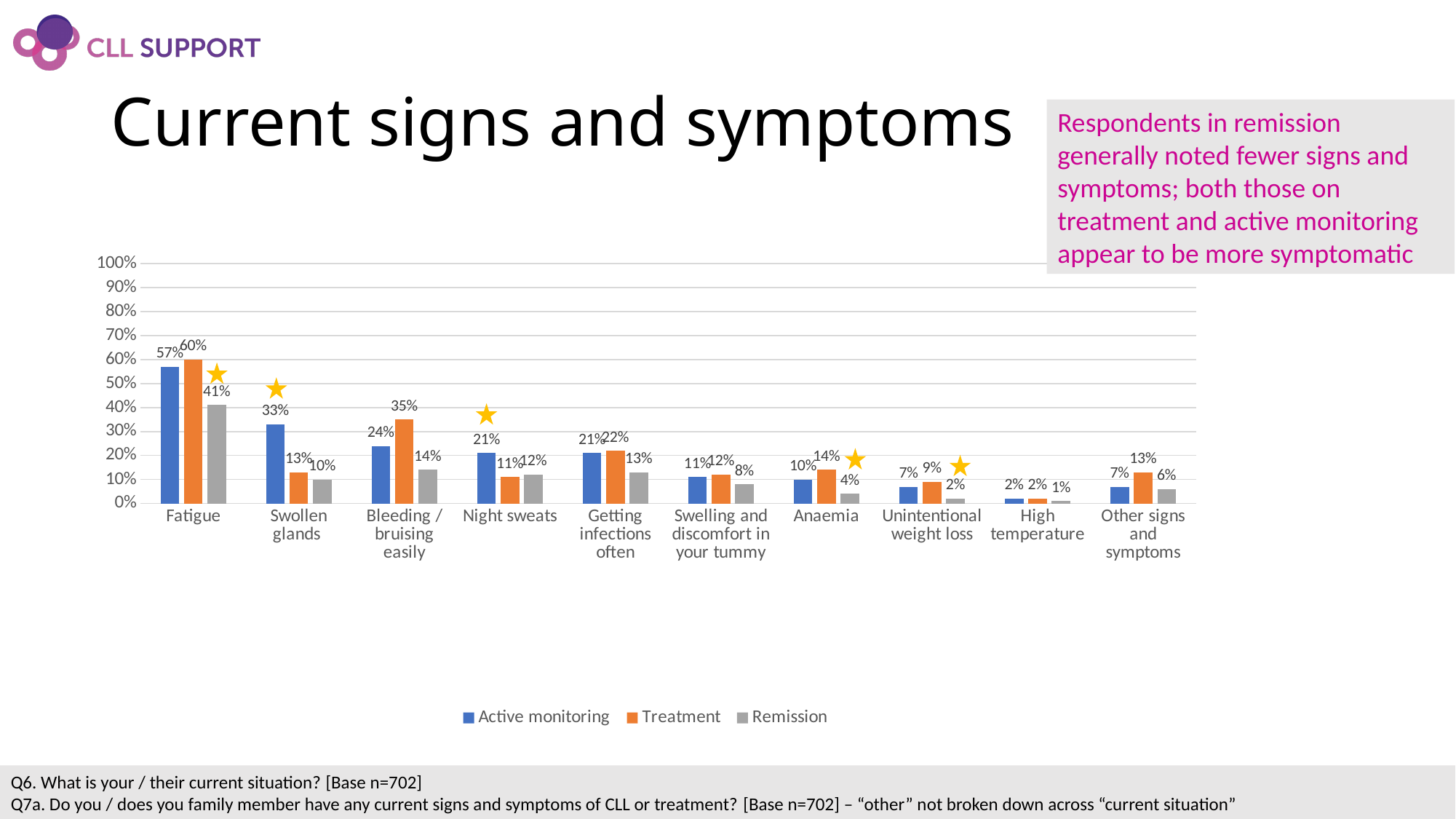
What is the Treatment value for Fatigue? 60% How many symptom categories are shown on the x axis? 10 What is the difference between the Active monitoring and Treatment values for Swollen glands? 20% What is the Remission value for Swollen glands? 10% Which category has the lowest Treatment value? High temperature Is the Active monitoring value for Fatigue greater or less than 50%? greater What is the Active monitoring value for Bleeding / bruising easily? 24% Which category has the highest Remission value? Fatigue How many series does the legend list? 3 For Anaemia, which is larger: the Treatment value or the Active monitoring value? Treatment What kind of chart is shown on the slide? bar chart Which series is shown in orange in the legend? Treatment